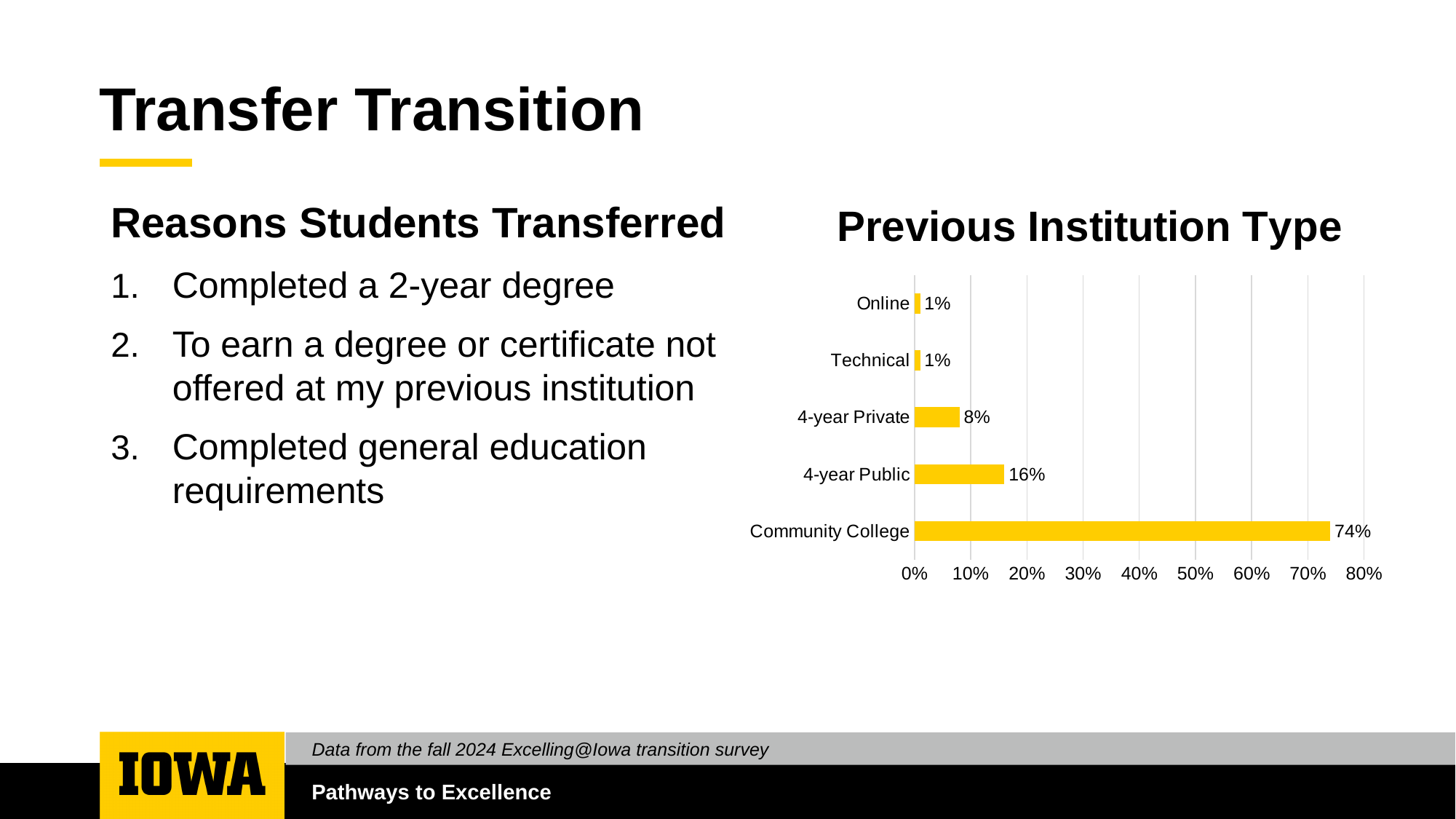
What is the value for 4-year Public? 16% What is the difference between the values for Community College and 4-year Public? 58% Is the value for Community College greater or less than 70%? greater Which previous institution type has the highest value? Community College What is the value for Online? 1% What is the difference between the values for 4-year Public and 4-year Private? 8% What is the value for Community College? 74% How many institution types are shown in the chart? 5 Which is larger, the value for 4-year Public or the value for 4-year Private? 4-year Public What is the value for 4-year Private? 8% What is the title of the chart? Previous Institution Type What kind of chart is shown on the slide? bar chart